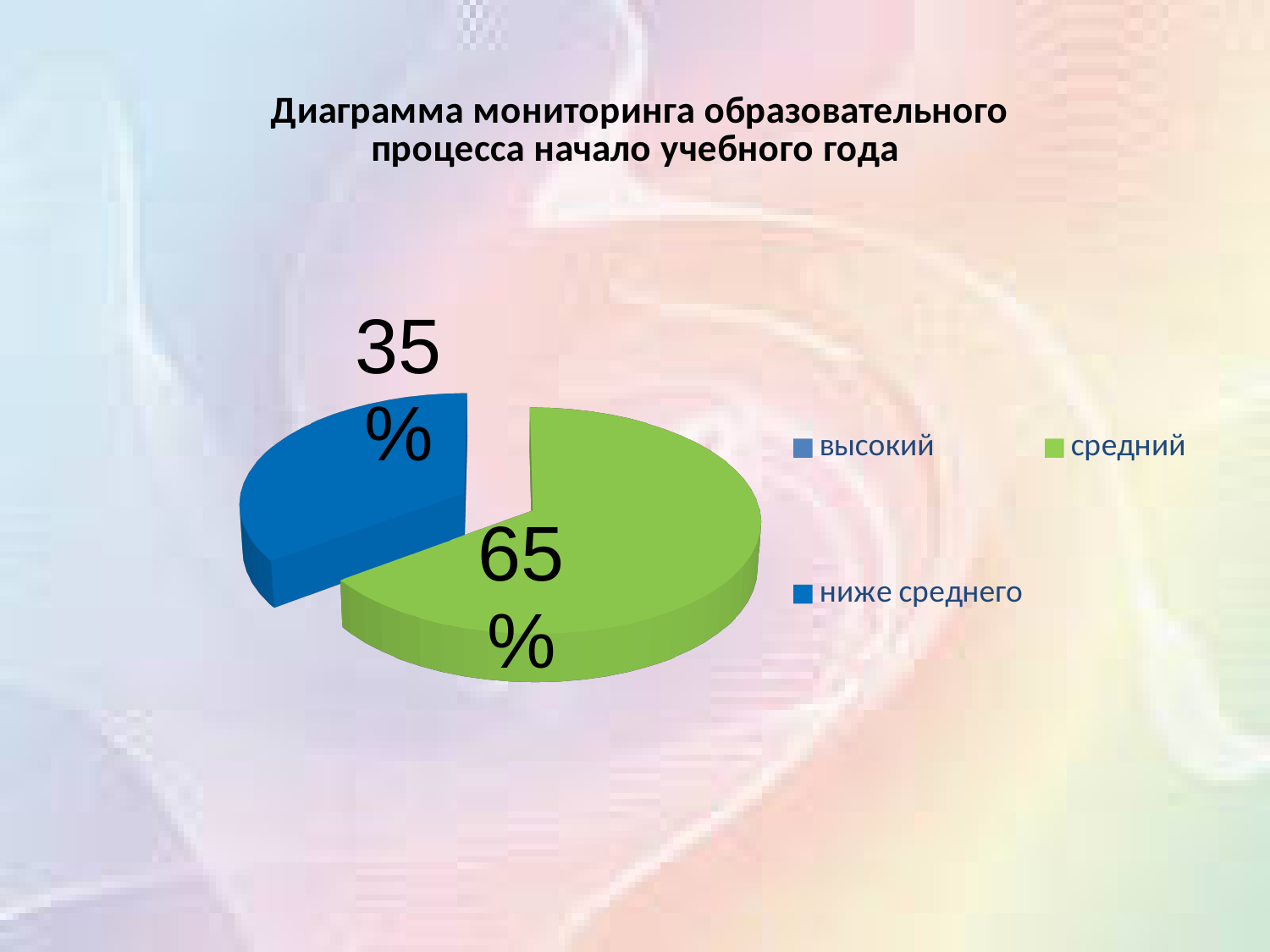
What percentage is shown for the средний slice? 65% What value is printed on the blue slice of the pie? 35% What kind of chart is shown on the slide? pie chart Which is larger, the green slice or the blue slice? the green slice What share of the pie does the средний slice take? 65% What is the difference between the 65% slice and the 35% slice? 30 percentage points Which slice of the pie is the largest? средний What colour represents средний in the legend? green How many slices are visible in the pie? 2 What is the title of the chart? Диаграмма мониторинга образовательного процесса начало учебного года How many entries does the legend list? 3